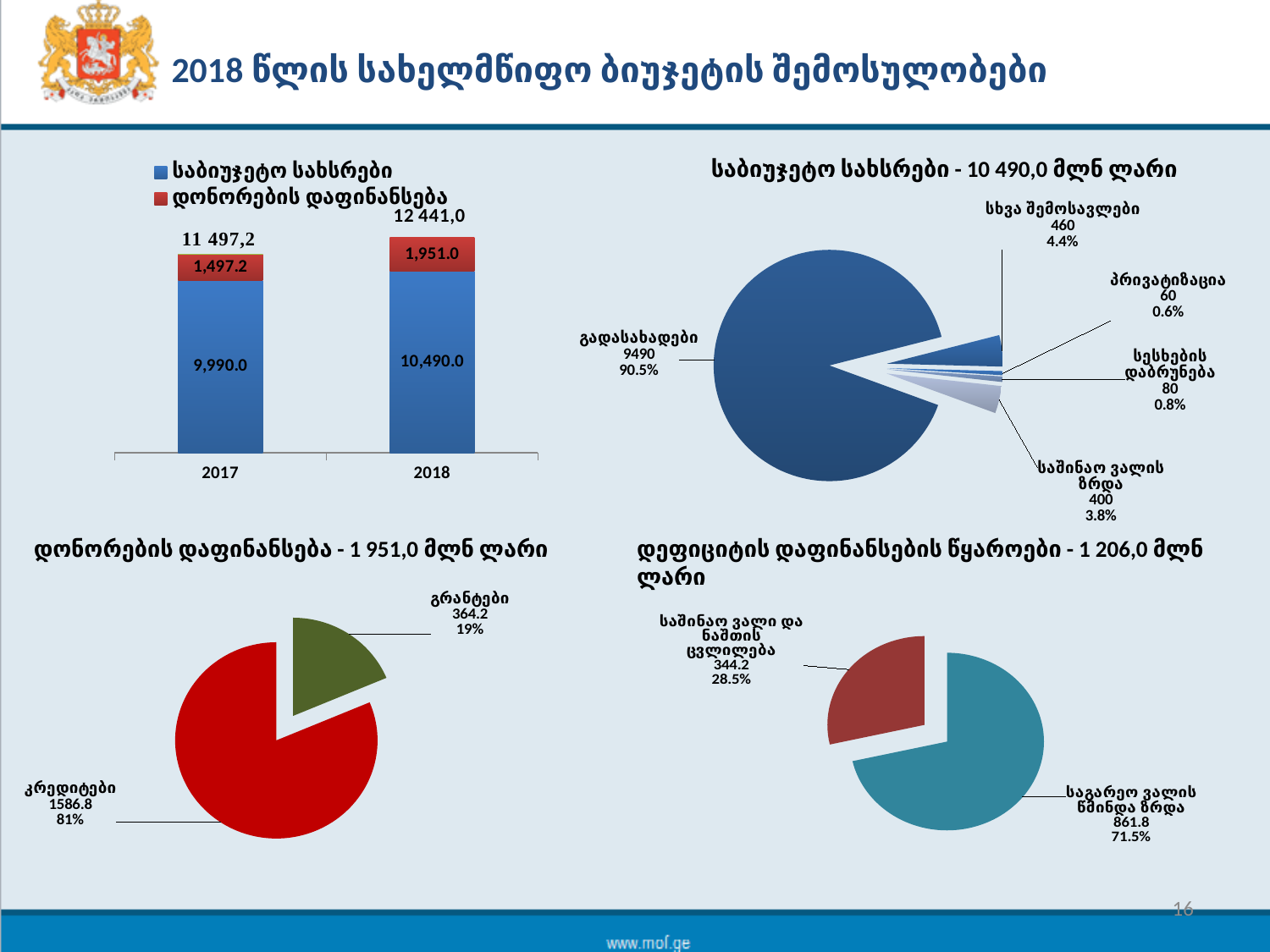
How many slices does the top-right pie chart (საბიუჯეტო სახსრები - 10 490,0 მლნ ლარი) have? 5 In the top-left bar chart, what is the value of საბიუჯეტო სახსრები for 2018? 10,490.0 In the bottom-left pie chart (დონორების დაფინანსება - 1 951,0 მლნ ლარი), what is the value for კრედიტები? 1586.8 How many series does the legend of the top-left bar chart list? 2 In the top-right pie chart (საბიუჯეტო სახსრები - 10 490,0 მლნ ლარი), what share does გადასახადები have? 90.5% In the top-left bar chart, what is the total of the stacked bar for 2018? 12 441,0 In the top-right pie chart (საბიუჯეტო სახსრები - 10 490,0 მლნ ლარი), which category is the smallest? პრივატიზაცია In the top-left bar chart, what is the difference between the საბიუჯეტო სახსრები values for 2018 and 2017? 500.0 What kind of chart is shown in the top-left of the slide? Bar chart In the bottom-left pie chart (დონორების დაფინანსება - 1 951,0 მლნ ლარი), which is larger, გრანტები or კრედიტები? კრედიტები In the bottom-right pie chart (დეფიციტის დაფინანსების წყაროები - 1 206,0 მლნ ლარი), what share does საგარეო ვალის წმინდა ზრდა have? 71.5% In the top-left bar chart, what is the value of დონორების დაფინანსება for 2017? 1,497.2